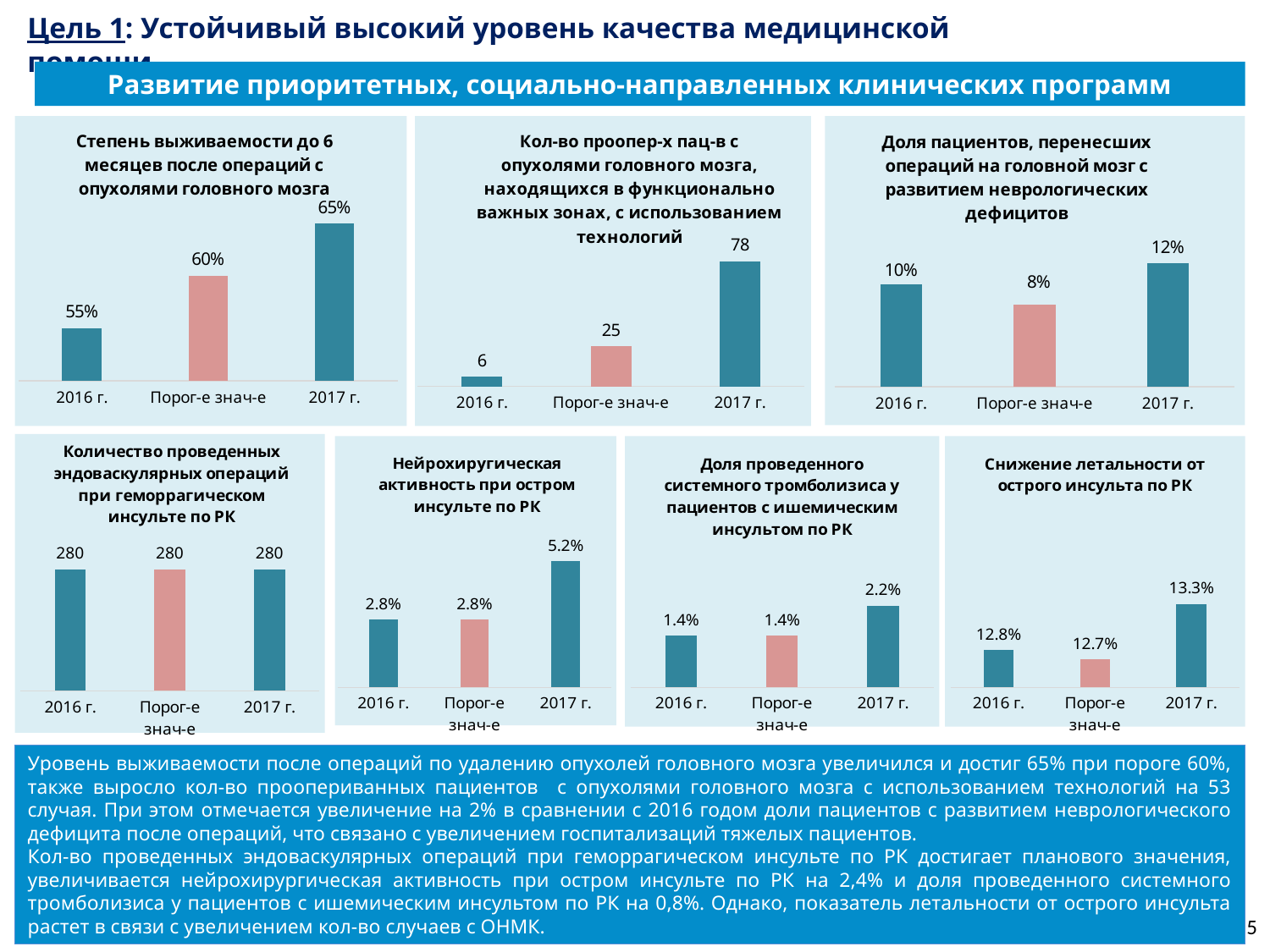
How many bars are shown in the chart 'Снижение летальности от острого инсульта по РК'? 3 In the chart 'Снижение летальности от острого инсульта по РК', what is the value for Порог-е знач-е? 12.7% In the chart 'Кол-во проопер-х пац-в с опухолями головного мозга, находящихся в функционально важных зонах, с использованием технологий', which category has the highest value? 2017 г. In the chart 'Количество проведенных эндоваскулярных операций при геморрагическом инсульте по РК', what is the value for 2017 г.? 280 In the chart 'Кол-во проопер-х пац-в с опухолями головного мозга, находящихся в функционально важных зонах, с использованием технологий', what is the value for 2016 г.? 6 In the chart 'Степень выживаемости до 6 месяцев после операций с опухолями головного мозга', what is the value for 2017 г.? 65% What type of chart is 'Нейрохиругическая активность при остром инсульте по РК'? bar chart In the chart 'Доля проведенного системного тромболизиса у пациентов с ишемическим инсультом по РК', what is the value for 2017 г.? 2.2% In the chart 'Степень выживаемости до 6 месяцев после операций с опухолями головного мозга', what is the difference between the 2017 г. value and the 2016 г. value? 10% In the chart 'Нейрохиругическая активность при остром инсульте по РК', is the value for 2017 г. larger or smaller than the value for 2016 г.? larger In the chart 'Доля пациентов, перенесших операций на головной мозг с развитием неврологических дефицитов', which category has the lowest value? Порог-е знач-е In the chart 'Доля пациентов, перенесших операций на головной мозг с развитием неврологических дефицитов', what is the value for Порог-е знач-е? 8%